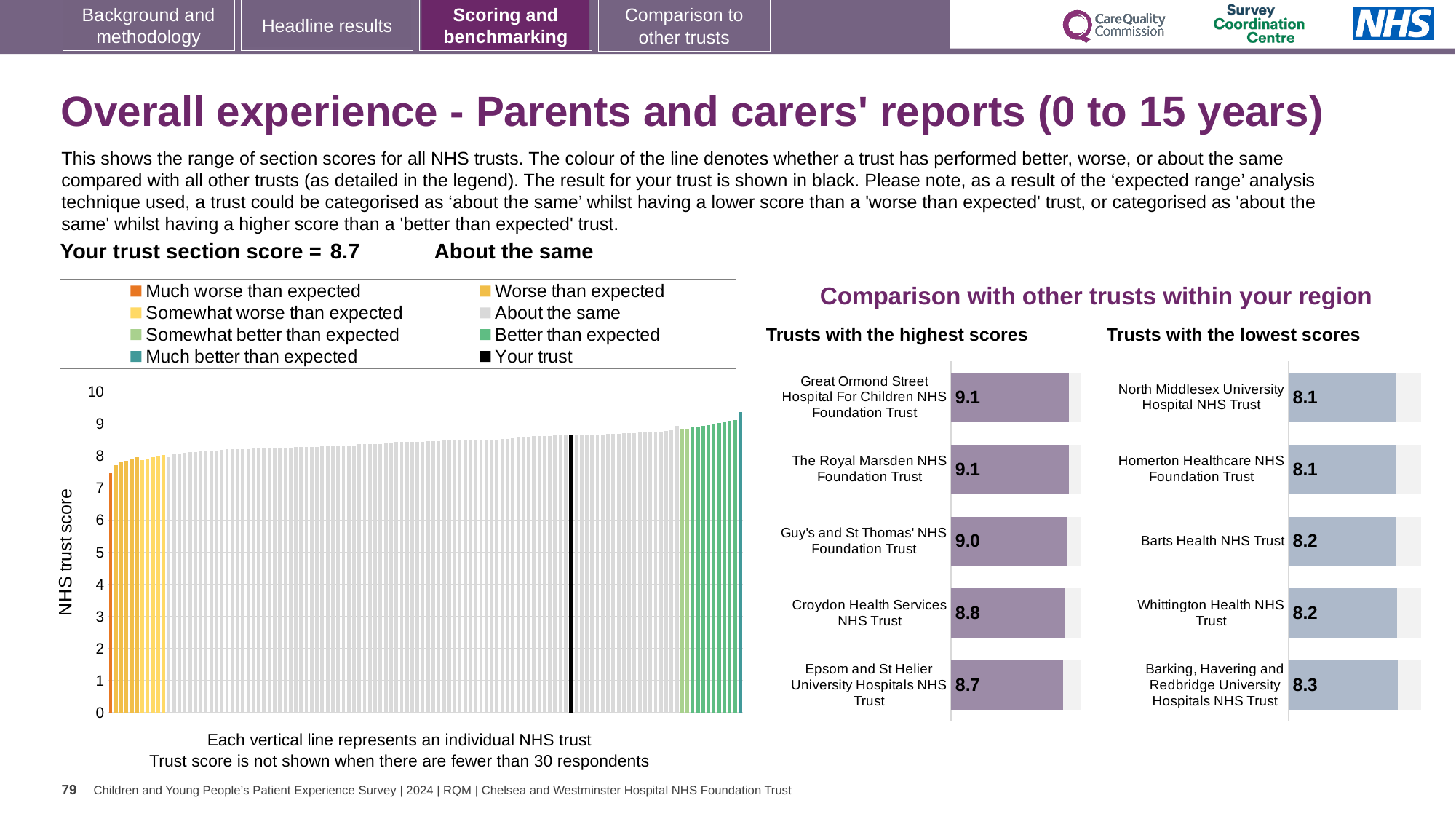
In the main NHS trust score chart, what colour represents 'Your trust' in the legend? Black In the main NHS trust score chart, what is the section score for your trust? 8.7 In the main NHS trust score chart, do the trust scores rise or fall from left to right along the x axis? Rise In the 'Trusts with the lowest scores' chart, what is the score for Barts Health NHS Trust? 8.2 How many trusts are shown in the 'Trusts with the highest scores' chart? 5 In the 'Trusts with the lowest scores' chart, which trust has the highest score? Barking, Havering and Redbridge University Hospitals NHS Trust In the 'Trusts with the highest scores' chart, what is the score for Great Ormond Street Hospital For Children NHS Foundation Trust? 9.1 In the 'Trusts with the highest scores' chart, what is the difference between the scores of Great Ormond Street Hospital For Children NHS Foundation Trust and Epsom and St Helier University Hospitals NHS Trust? 0.4 Which has the higher score: Croydon Health Services NHS Trust in the highest scores chart or Whittington Health NHS Trust in the lowest scores chart? Croydon Health Services NHS Trust How many entries does the legend of the main NHS trust score chart list? 8 What kind of chart is the main 'NHS trust score' chart on the left? Bar chart In the 'Trusts with the highest scores' chart, which trust has the lowest score? Epsom and St Helier University Hospitals NHS Trust